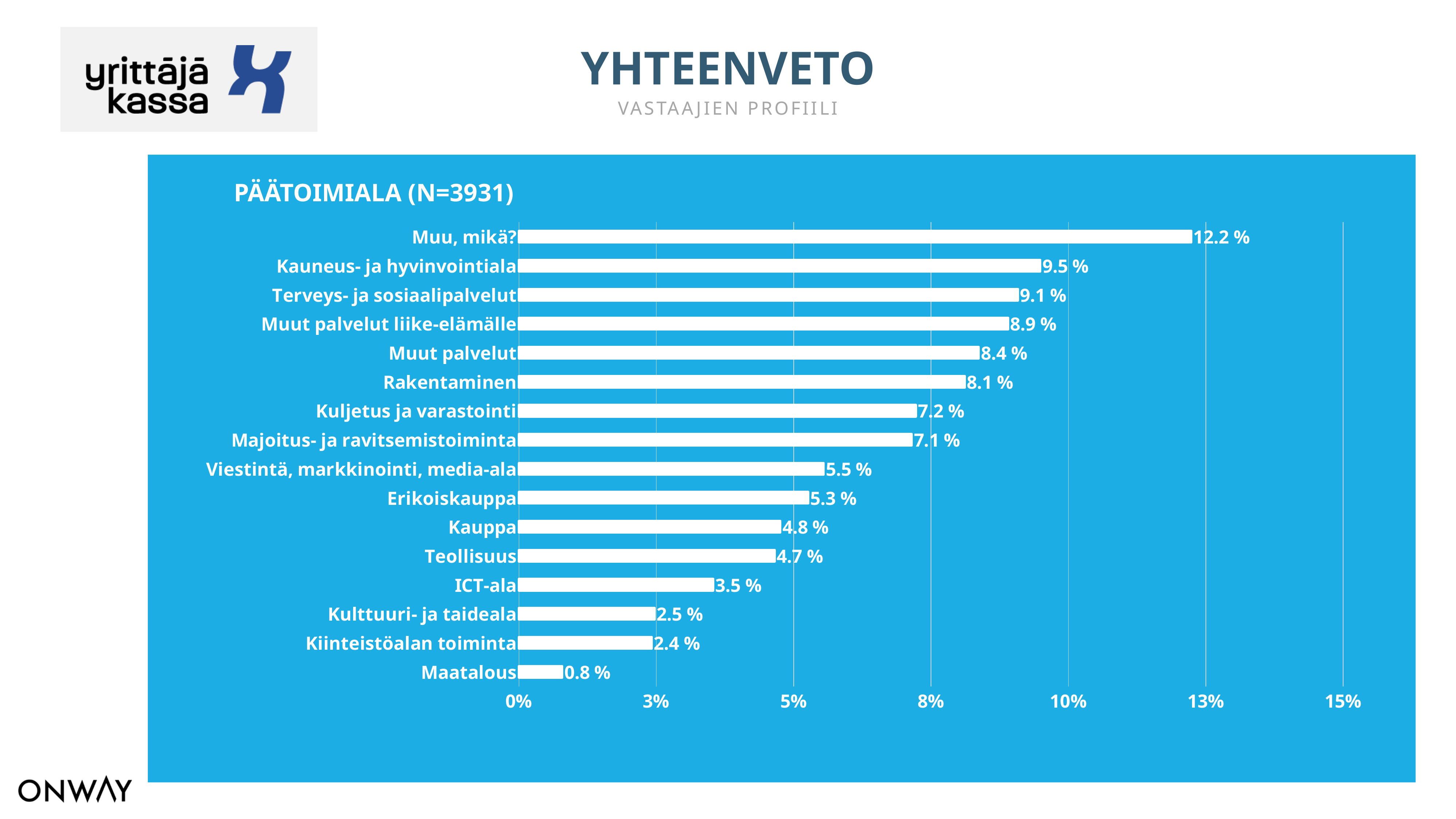
What is the difference between the values for Kulttuuri- ja taideala and Maatalous? 1.7 % What is the value for Rakentaminen? 8.1 % What is the difference between the values for Muu, mikä? and Kauneus- ja hyvinvointiala? 2.7 % Which is larger, the value for Kuljetus ja varastointi or the value for Erikoiskauppa? Kuljetus ja varastointi What kind of chart is shown on the slide? bar chart How many categories are shown in the chart? 16 Which category has the lowest value? Maatalous Is the value for Terveys- ja sosiaalipalvelut greater or less than 8%? greater What is the value for ICT-ala? 3.5 % What is the value for Kauneus- ja hyvinvointiala? 9.5 % Which category has the highest value? Muu, mikä? What is the title of the chart? PÄÄTOIMIALA (N=3931)